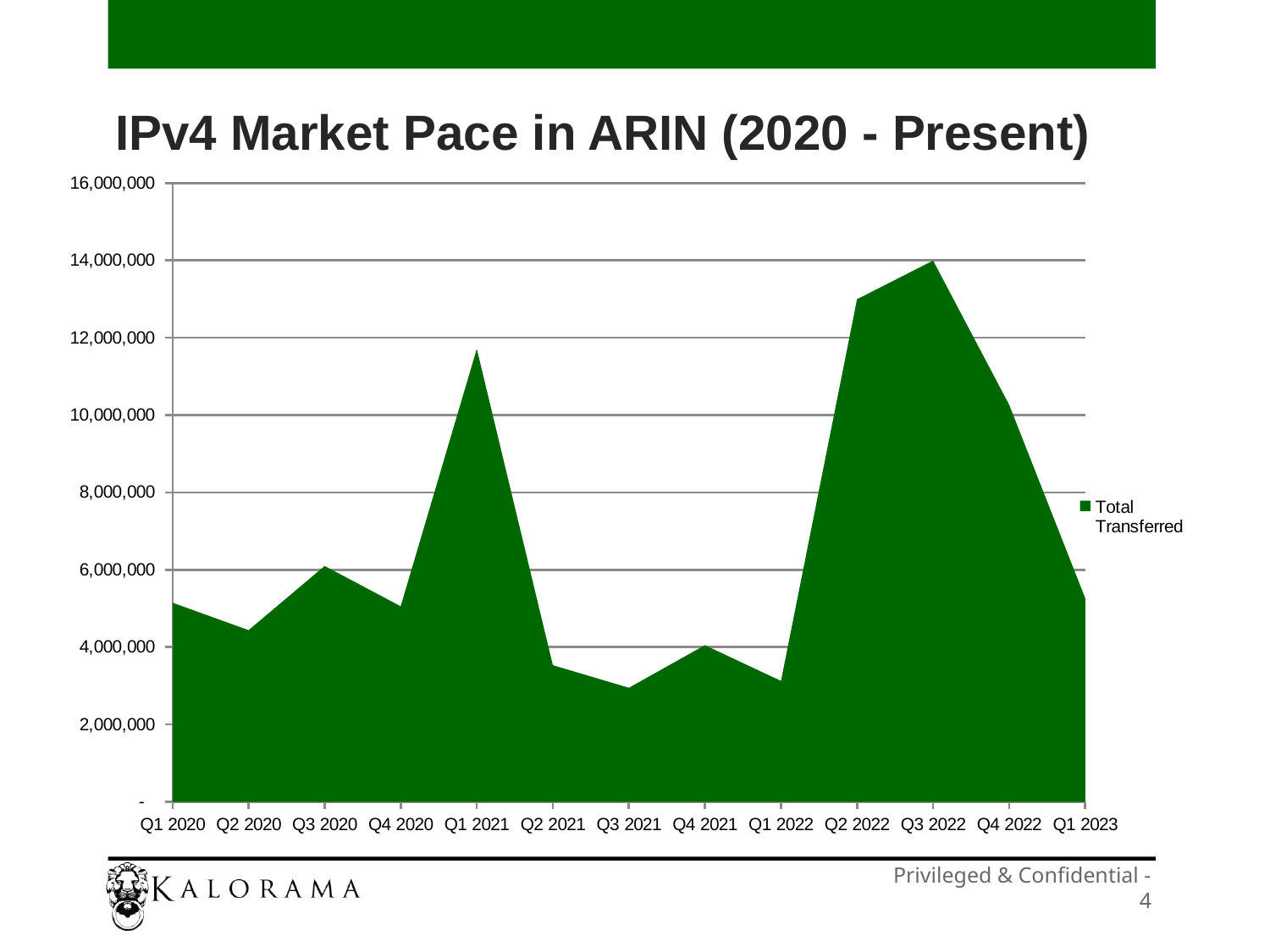
How many series does the legend list? 1 Which quarter has the highest Total Transferred value? Q3 2022 Do the values rise or fall from Q3 2022 to Q1 2023? fall Is the value for Q2 2022 greater or less than 12,000,000? greater Is the value for Q1 2023 greater or less than 6,000,000? less Is the value for Q2 2021 greater or less than 4,000,000? less How many quarters are plotted along the x axis? 13 What is the name of the series shown in the legend? Total Transferred What kind of chart is shown on the slide? Area chart What is the title of the chart? IPv4 Market Pace in ARIN (2020 - Present) Which is larger, the value for Q3 2020 or the value for Q4 2020? Q3 2020